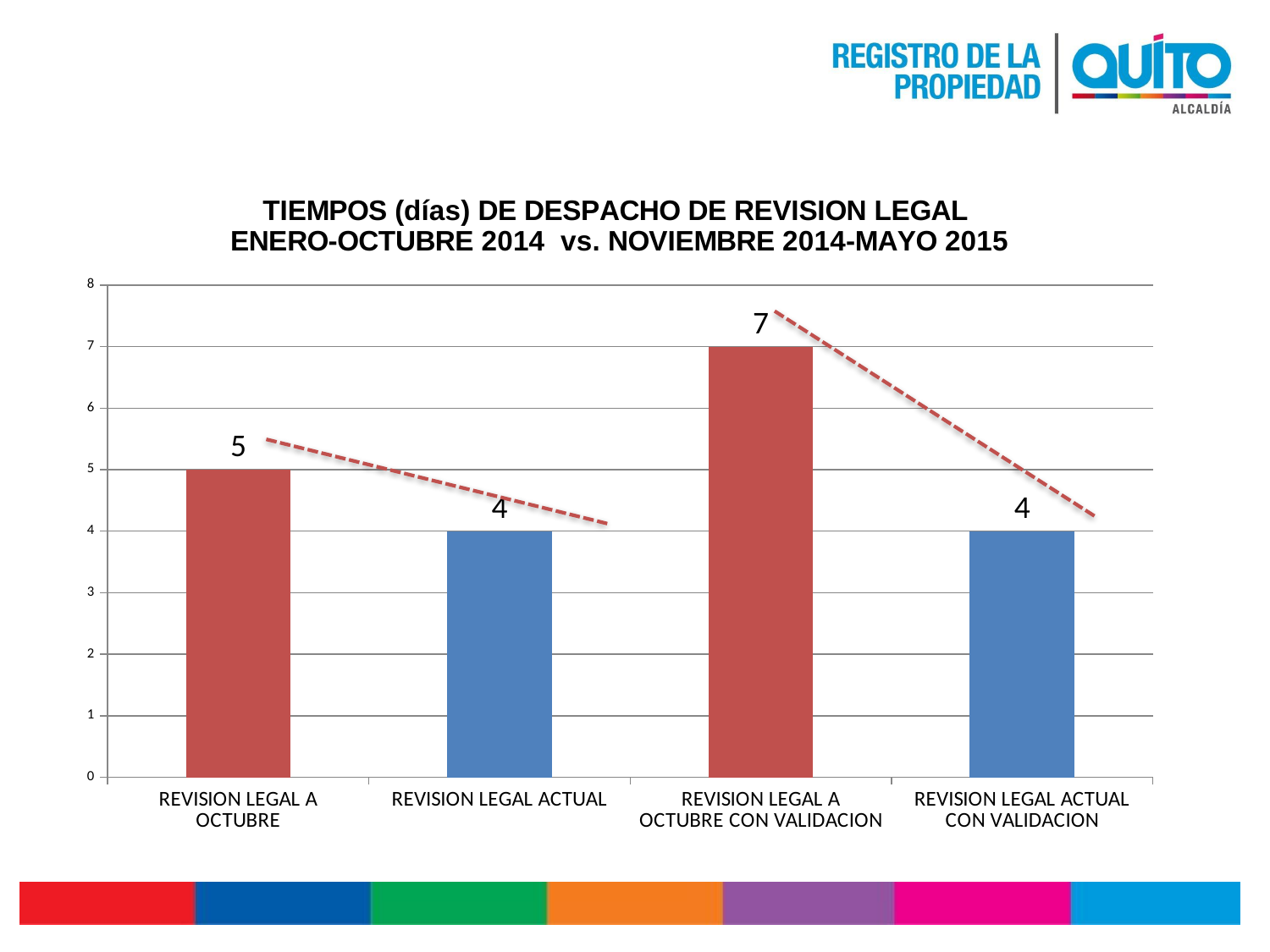
What is the value for REVISION LEGAL A OCTUBRE CON VALIDACION? 7 What kind of chart is shown on the slide? bar chart Which category has the highest value? REVISION LEGAL A OCTUBRE CON VALIDACION What is the maximum value shown on the vertical axis? 8 What is the value for REVISION LEGAL ACTUAL CON VALIDACION? 4 Which is larger, REVISION LEGAL A OCTUBRE or REVISION LEGAL ACTUAL? REVISION LEGAL A OCTUBRE What is the difference between REVISION LEGAL A OCTUBRE and REVISION LEGAL ACTUAL? 1 Is the value for REVISION LEGAL A OCTUBRE CON VALIDACION greater or less than 6? greater What is the value for REVISION LEGAL A OCTUBRE? 5 What is the difference between REVISION LEGAL A OCTUBRE CON VALIDACION and REVISION LEGAL ACTUAL CON VALIDACION? 3 How many categories are shown on the x axis? 4 What colour are the bars for the REVISION LEGAL ACTUAL categories? blue